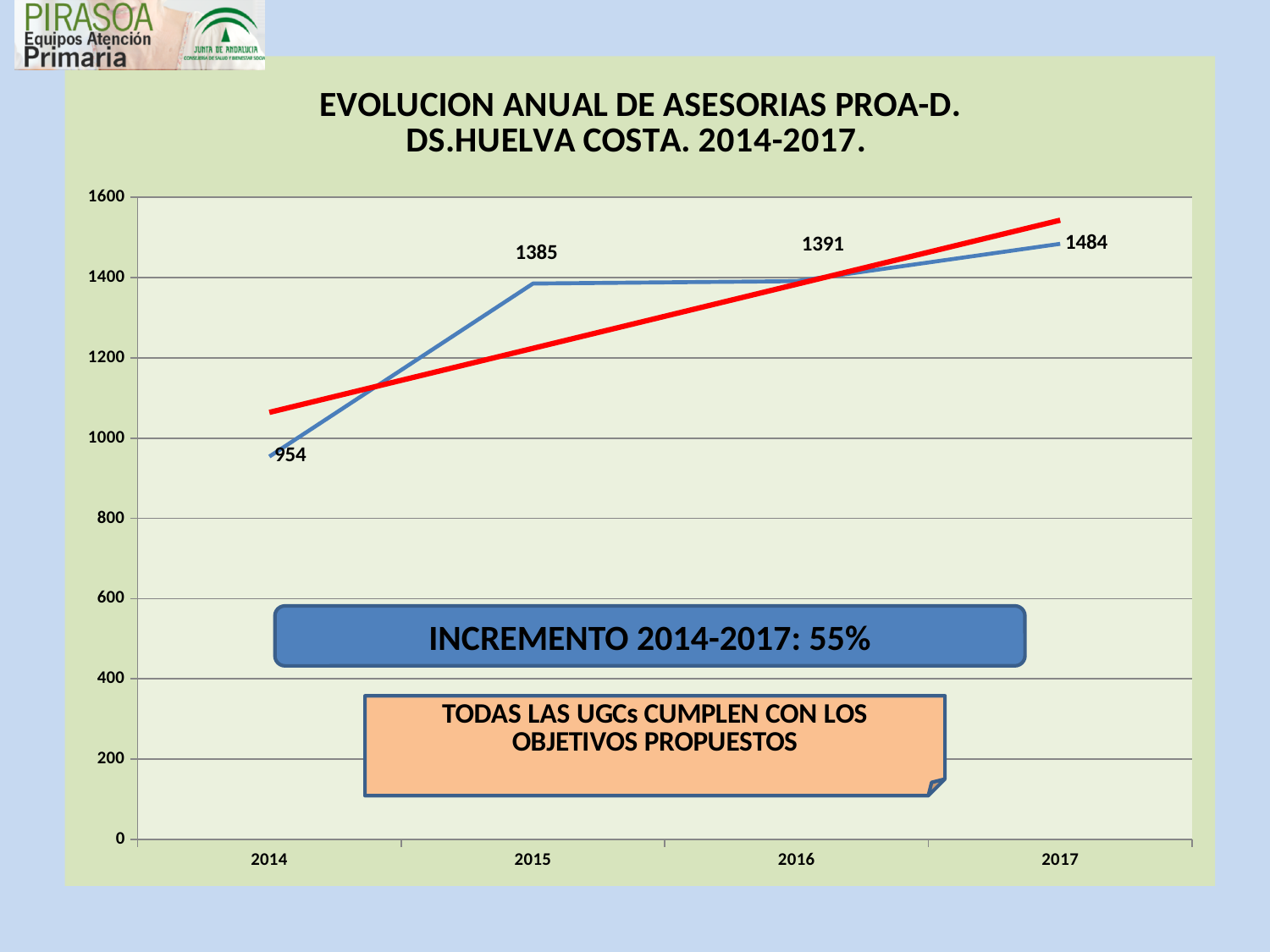
Which is larger, the value for 2015 or the value for 2017? 2017 Which year has the highest value? 2017 What is the value for 2016? 1391 What is the value for 2015? 1385 What is the difference between the values for 2017 and 2014? 530 Which year has the lowest value? 2014 How many years are plotted on the x axis? 4 Is the value for 2014 greater or less than 1000? less What kind of chart is shown? line chart Do the values rise or fall from 2014 to 2017? rise What is the value for 2014? 954 What is the value for 2017? 1484